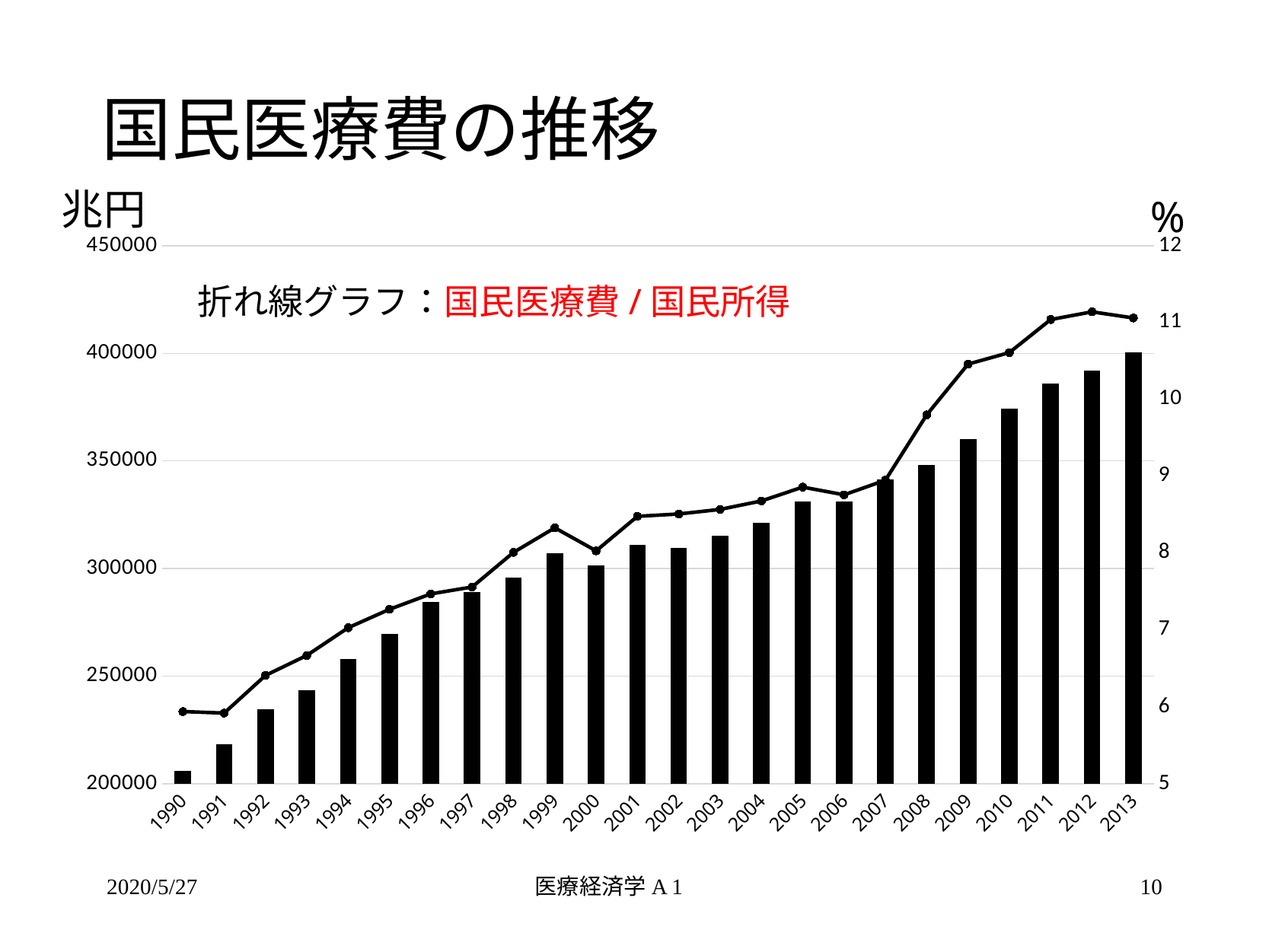
What kind of chart is shown on the slide? A combined bar and line chart According to the annotation on the slide, what does the line graph represent? 国民医療費 / 国民所得 Which year has the tallest bar in the chart? 2013 Which year has the higher line value, 1999 or 2000? 1999 Is the line value for 2008 greater or less than 9%? greater How many years are shown along the x axis of the chart? 24 Is the bar value for 1990 greater or less than 250000? less What is the title of the chart on the slide? 国民医療費の推移 Which year has the shortest bar in the chart? 1990 Is the bar value for 2012 greater or less than 400000? less Do the bar values generally rise or fall from 1990 to 2013? Rise